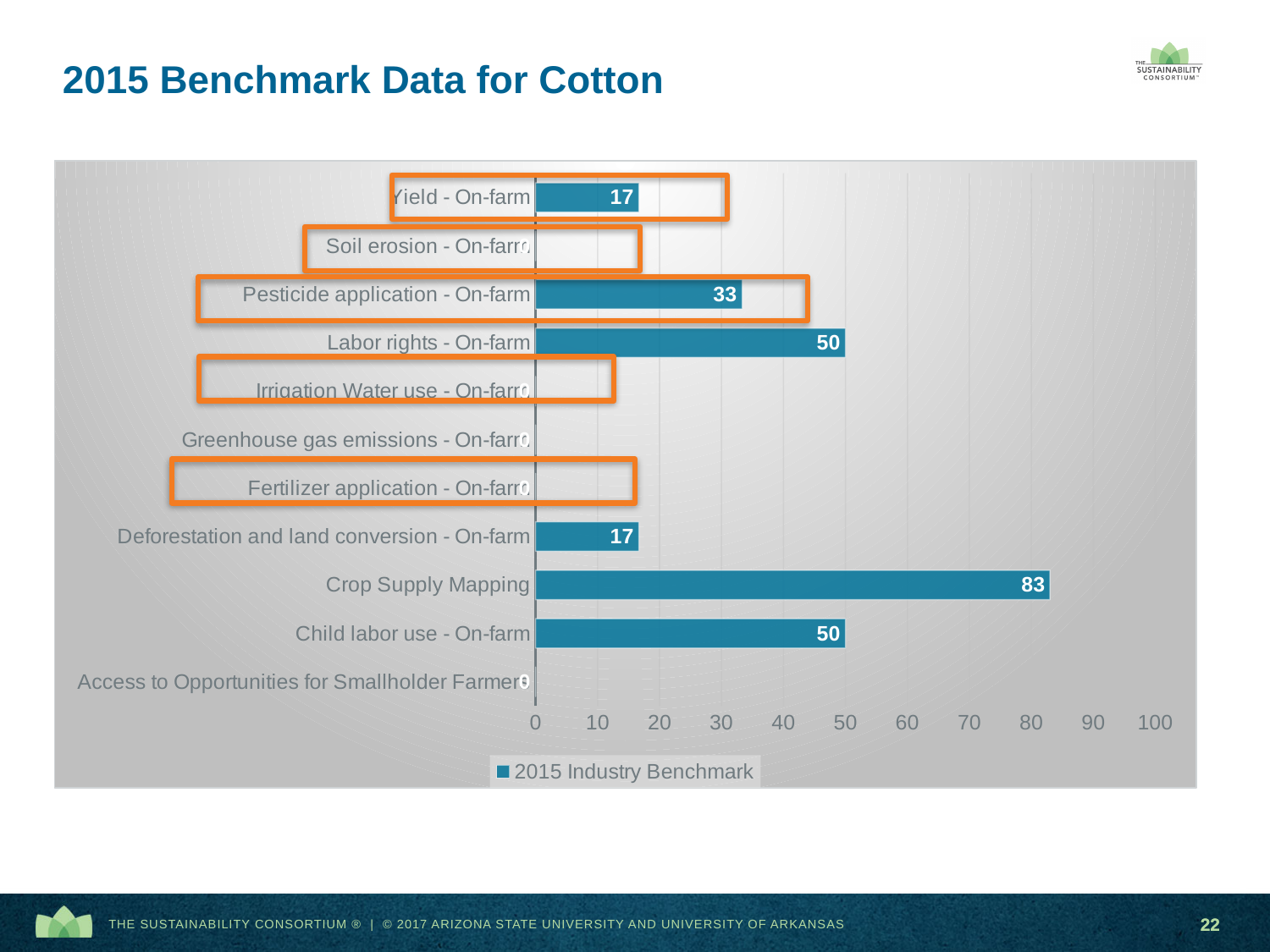
How many categories are shown on the chart? 11 Is the value for Crop Supply Mapping greater or less than 80? greater What is the difference between the values for Pesticide application - On-farm and Yield - On-farm? 16 What is the value shown for Labor rights - On-farm? 50 What is the value shown for Deforestation and land conversion - On-farm? 17 Which is larger, the value for Labor rights - On-farm or the value for Pesticide application - On-farm? Labor rights - On-farm What is the value shown for Pesticide application - On-farm? 33 What is the difference between the values for Crop Supply Mapping and Child labor use - On-farm? 33 What kind of chart is shown on the slide? Bar chart What series name does the legend show? 2015 Industry Benchmark Which category has the highest 2015 Industry Benchmark value? Crop Supply Mapping What is the 2015 Industry Benchmark value for Crop Supply Mapping? 83